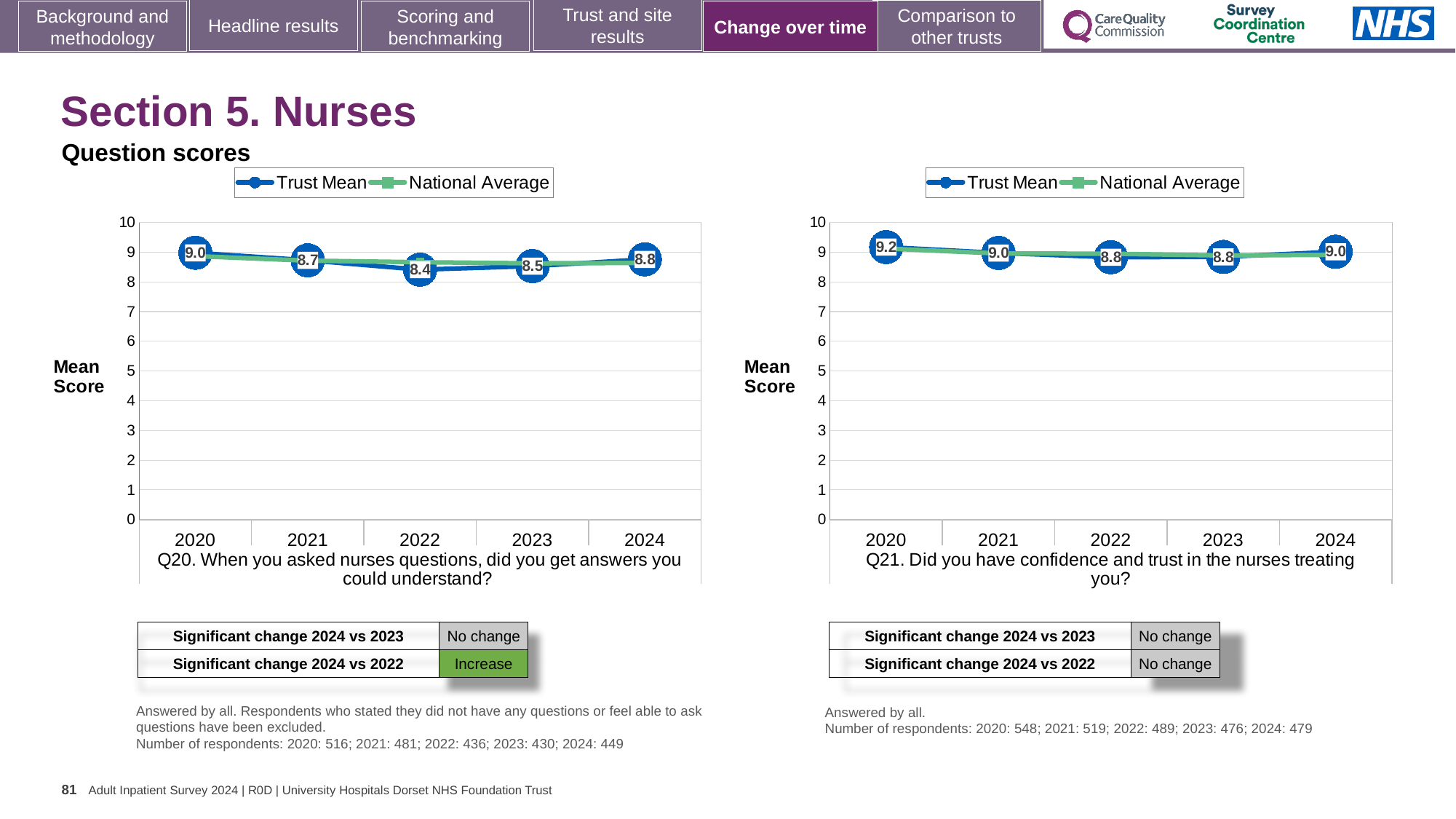
In the Q21 chart (right), what is the Trust Mean for 2020? 9.2 In the Q20 chart (left), what is the Trust Mean for 2024? 8.8 In the Q20 chart (left), which year has the lowest Trust Mean? 2022 In the Q20 chart (left), is the Trust Mean for 2023 greater or less than 8? greater What kind of chart is the Q21 chart (right)? Line chart In the Q20 chart (left), what is the Trust Mean for 2022? 8.4 In the Q21 chart (right), is the Trust Mean higher in 2020 or in 2021? 2020 In the Q21 chart (right), which year has the highest Trust Mean? 2020 In the Q20 chart (left), what is the difference between the Trust Mean in 2020 and in 2022? 0.6 How many years are plotted on the x axis of the Q21 chart (right)? 5 In the Q21 chart (right), what is the Trust Mean for 2023? 8.8 How many series does the legend of the Q20 chart (left) list? 2